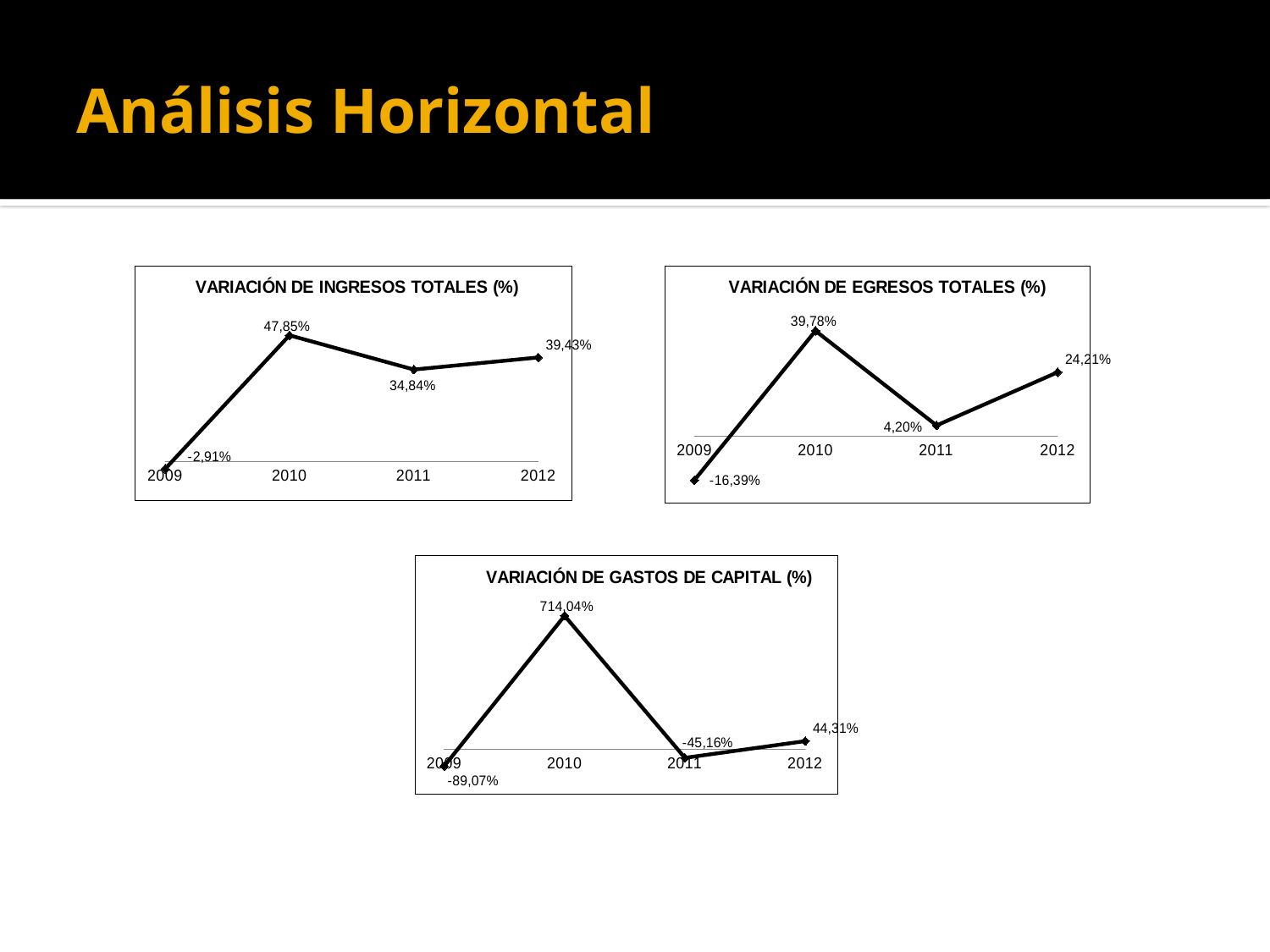
In the chart titled VARIACIÓN DE INGRESOS TOTALES (%), which year has the lowest value? 2009 How many data points are plotted in the chart titled VARIACIÓN DE GASTOS DE CAPITAL (%)? 4 In the chart titled VARIACIÓN DE GASTOS DE CAPITAL (%), what is the value for 2010? 714,04% In the chart titled VARIACIÓN DE GASTOS DE CAPITAL (%), which year has the lowest value? 2009 In the chart titled VARIACIÓN DE EGRESOS TOTALES (%), which is larger, the value for 2010 or the value for 2012? 2010 In the chart titled VARIACIÓN DE INGRESOS TOTALES (%), which year has the highest value? 2010 In the chart titled VARIACIÓN DE GASTOS DE CAPITAL (%), what is the value for 2011? -45,16% In the chart titled VARIACIÓN DE INGRESOS TOTALES (%), what is the value for 2009? -2,91% What kind of chart is the chart titled VARIACIÓN DE EGRESOS TOTALES (%)? Line chart In the chart titled VARIACIÓN DE INGRESOS TOTALES (%), what is the value for 2010? 47,85% In the chart titled VARIACIÓN DE EGRESOS TOTALES (%), what is the value for 2011? 4,20% In the chart titled VARIACIÓN DE EGRESOS TOTALES (%), what is the value for 2009? -16,39%